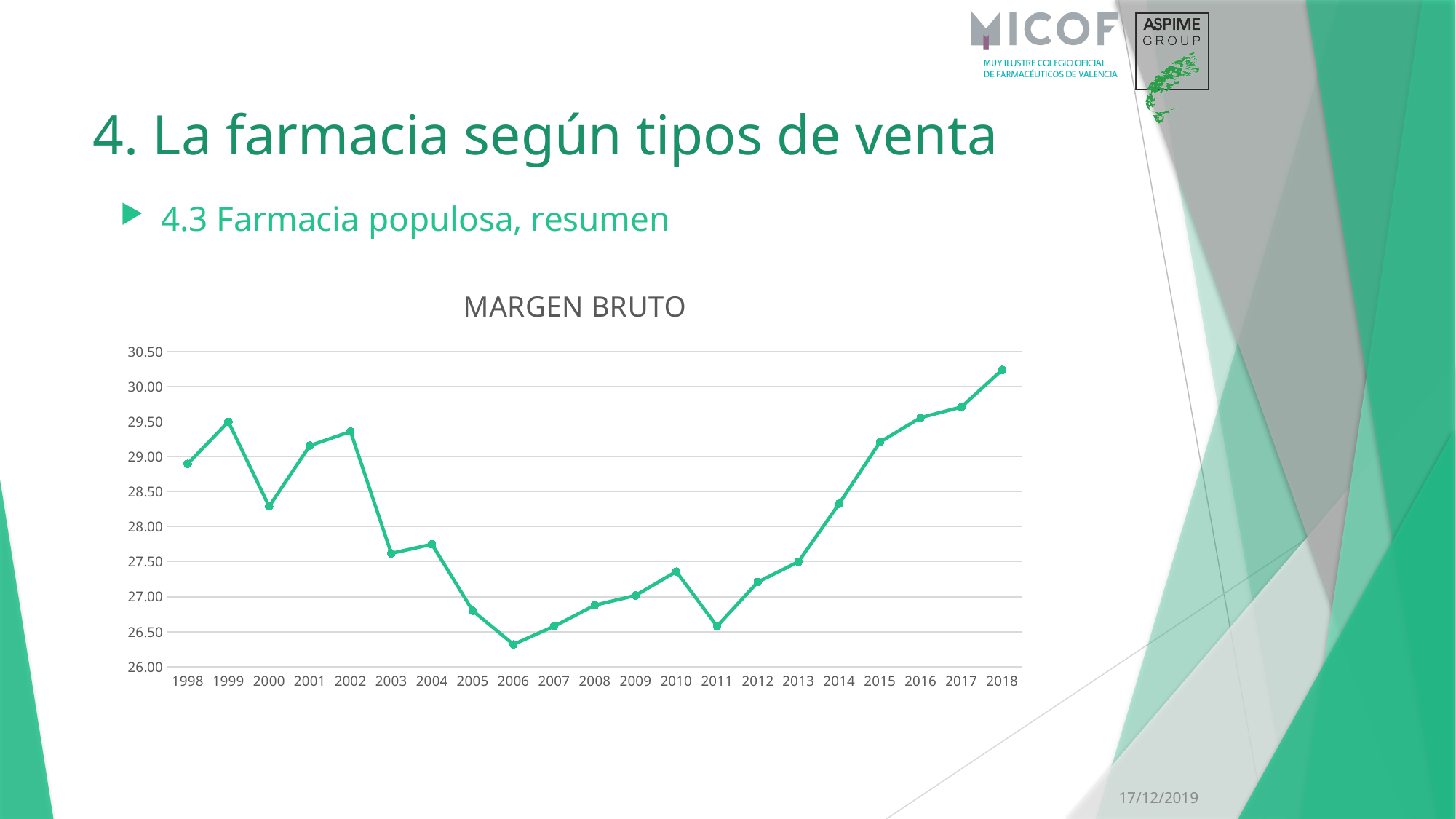
How many years are plotted on the x axis of the chart? 21 Do the values rise or fall from 2011 to 2018? rise Is the value for 2018 greater or less than 30.00? greater Is the value for 2006 greater or less than 26.50? less What is the title of the chart? MARGEN BRUTO Which year has the larger value, 1999 or 2000? 1999 Which year has the larger value, 2002 or 2003? 2002 Is the value for 2000 greater or less than 28.50? less Which year has the lowest value in the chart? 2006 Which year has the highest value in the chart? 2018 What kind of chart is shown on the slide? line chart